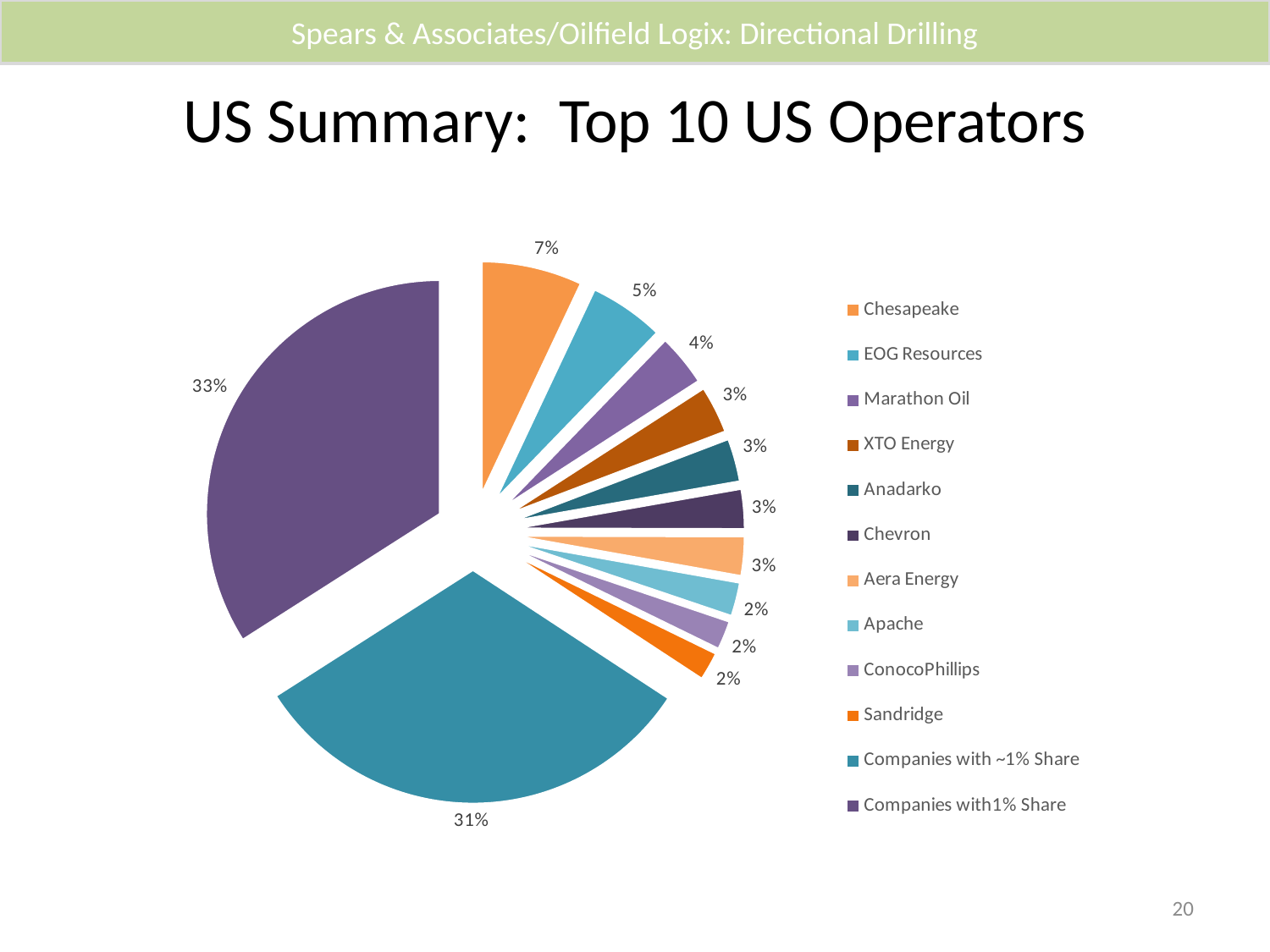
How many entries does the legend list? 12 Which category has the largest slice of the pie? Companies with1% Share What is the value shown for Companies with ~1% Share? 31% What share of the pie does Chesapeake hold? 7% How many slices does the pie chart have? 12 What is the title of the slide containing the pie chart? US Summary: Top 10 US Operators Which is larger, the slice for Chesapeake or the slice for EOG Resources? Chesapeake What is the difference between the Companies with1% Share slice and the Companies with ~1% Share slice? 2% What is the difference between the Chesapeake slice and the Marathon Oil slice? 3% What is the value shown for Marathon Oil? 4% What is the value shown for EOG Resources? 5% What type of chart is shown on the slide? pie chart